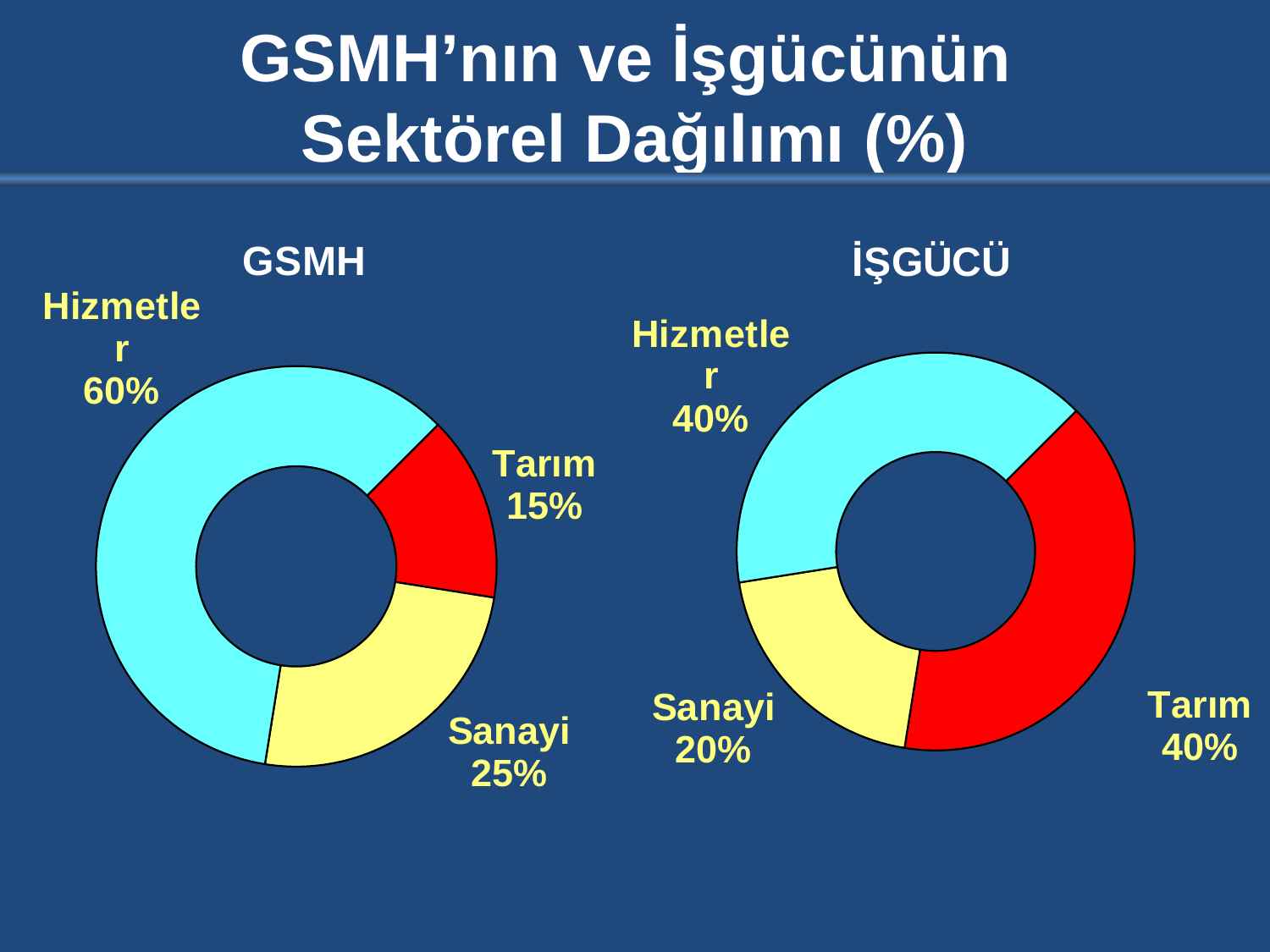
In the GSMH chart, what is the value for Tarım? 15% What kind of chart is the GSMH chart? Doughnut chart How many sectors are shown in the İŞGÜCÜ chart? 3 In the İŞGÜCÜ chart, which sector has the smallest share? Sanayi In the İŞGÜCÜ chart, what is the difference between the Tarım and Sanayi shares? 20% In the İŞGÜCÜ chart, what is the value for Tarım? 40% In the İŞGÜCÜ chart, what is the value for Sanayi? 20% In the GSMH chart, which is larger, Sanayi or Tarım? Sanayi In the GSMH chart, which sector has the largest share? Hizmetler In the GSMH chart, what is the difference between the Hizmetler and Sanayi shares? 35% In the GSMH chart, what is the value for Hizmetler? 60% In the GSMH chart, which sector has the smallest share? Tarım